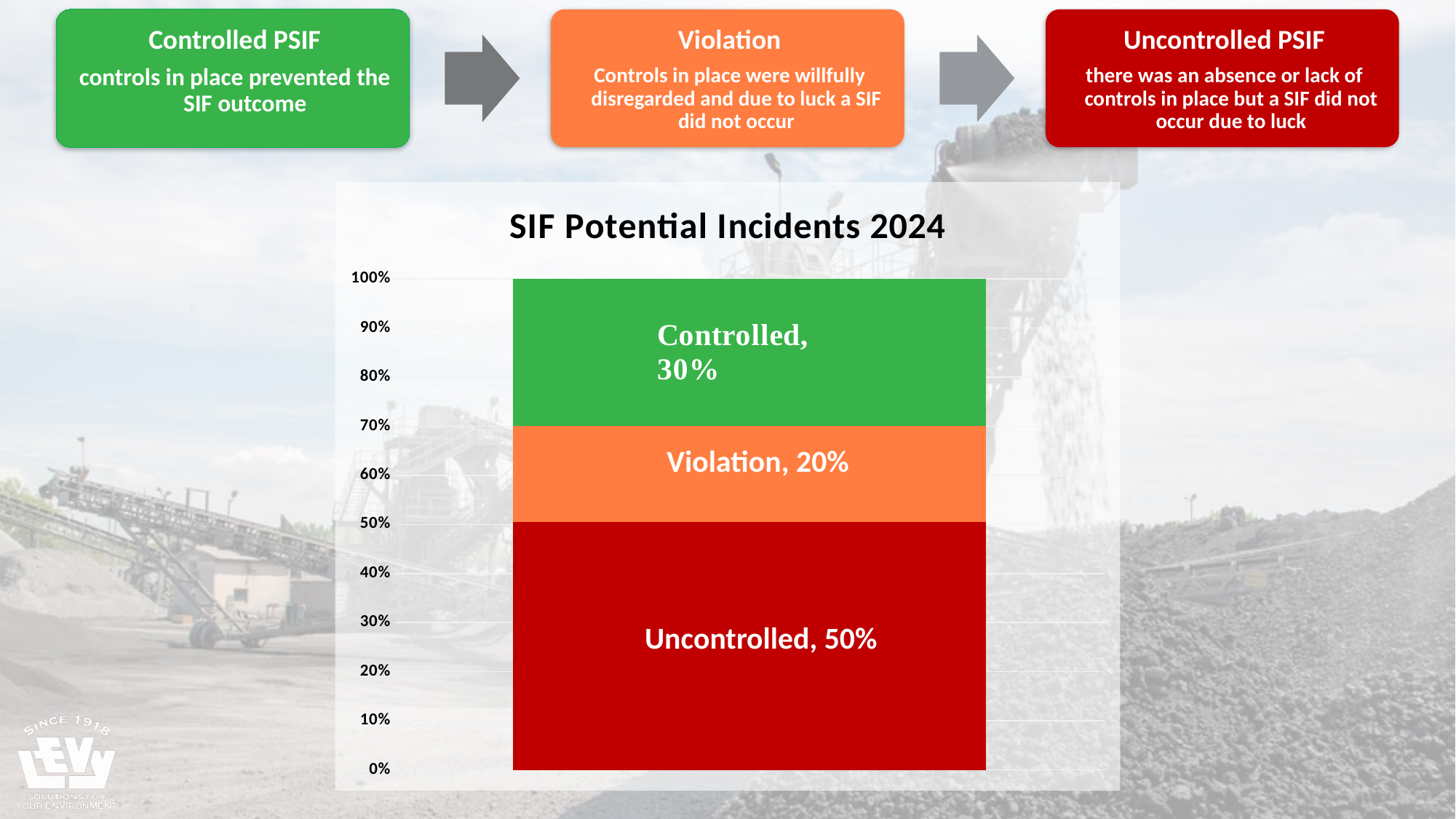
What is the total of the stacked bar in the SIF Potential Incidents 2024 chart? 100% What kind of chart is the SIF Potential Incidents 2024 chart? Stacked bar chart Which is larger in the SIF Potential Incidents 2024 chart, Controlled or Violation? Controlled What is the value for Violation in the SIF Potential Incidents 2024 chart? 20% What colour is the Uncontrolled segment in the SIF Potential Incidents 2024 chart? Red Which segment has the lowest value in the SIF Potential Incidents 2024 chart? Violation What is the value for Controlled in the SIF Potential Incidents 2024 chart? 30% How many segments make up the stacked bar in the SIF Potential Incidents 2024 chart? 3 Which segment has the highest value in the SIF Potential Incidents 2024 chart? Uncontrolled What is the difference between the Uncontrolled and Controlled values in the SIF Potential Incidents 2024 chart? 20% What is the title of the chart on the slide? SIF Potential Incidents 2024 What is the value for Uncontrolled in the SIF Potential Incidents 2024 chart? 50%